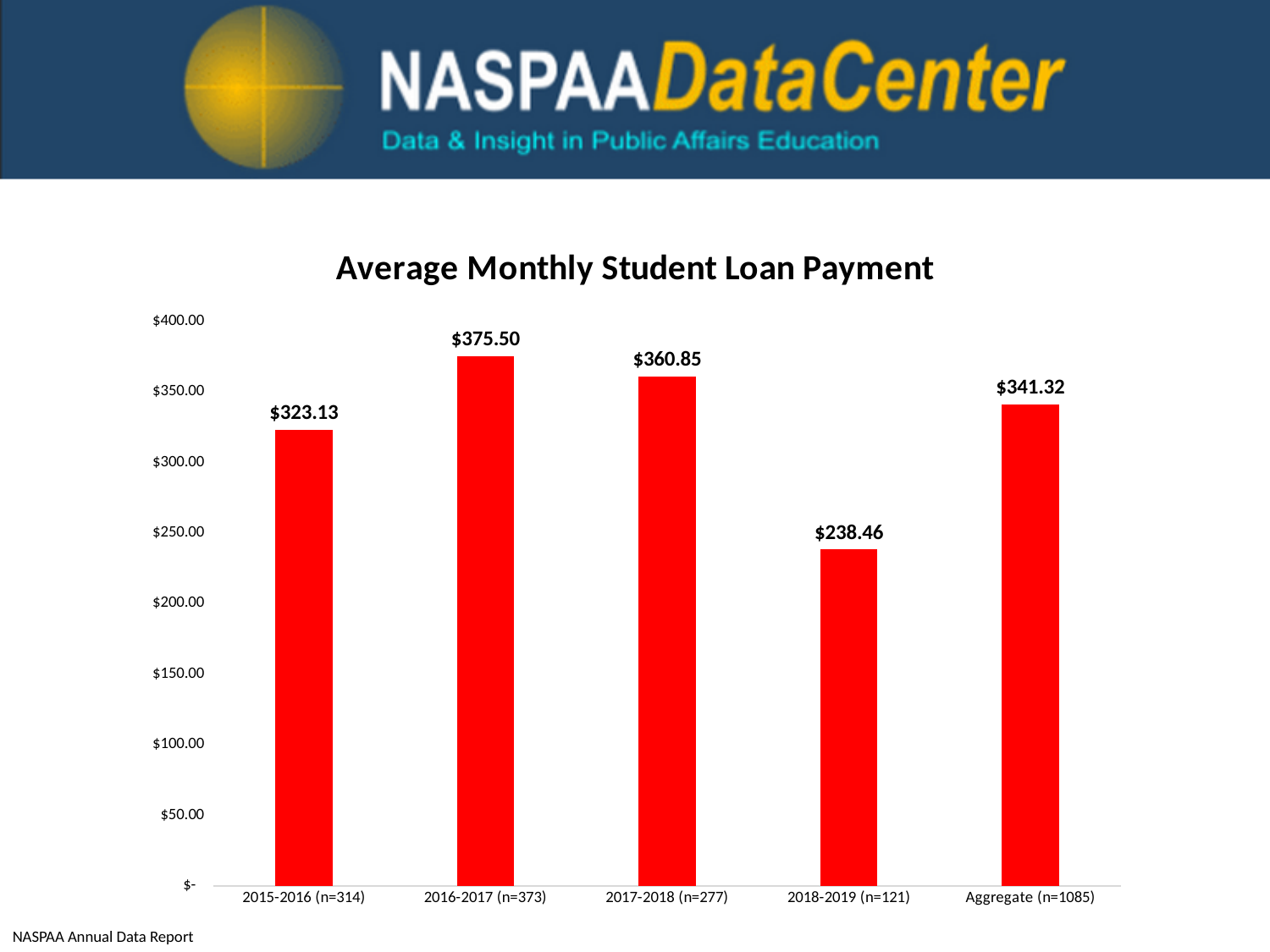
What colour are the bars in the chart? red What is the difference between the 2016-2017 and 2017-2018 average monthly student loan payments? $14.65 Is the value for 2018-2019 (n=121) greater or less than $250.00? less What is the Aggregate (n=1085) average monthly student loan payment? $341.32 What is the average monthly student loan payment for 2018-2019 (n=121)? $238.46 Which is larger, the average monthly payment for 2015-2016 or for 2017-2018? 2017-2018 Which category has the lowest average monthly student loan payment? 2018-2019 (n=121) What is the average monthly student loan payment for 2015-2016 (n=314)? $323.13 Which category has the highest average monthly student loan payment? 2016-2017 (n=373) What kind of chart is shown on the slide? bar chart How many categories are shown on the x axis of the chart? 5 What is the title of the chart? Average Monthly Student Loan Payment